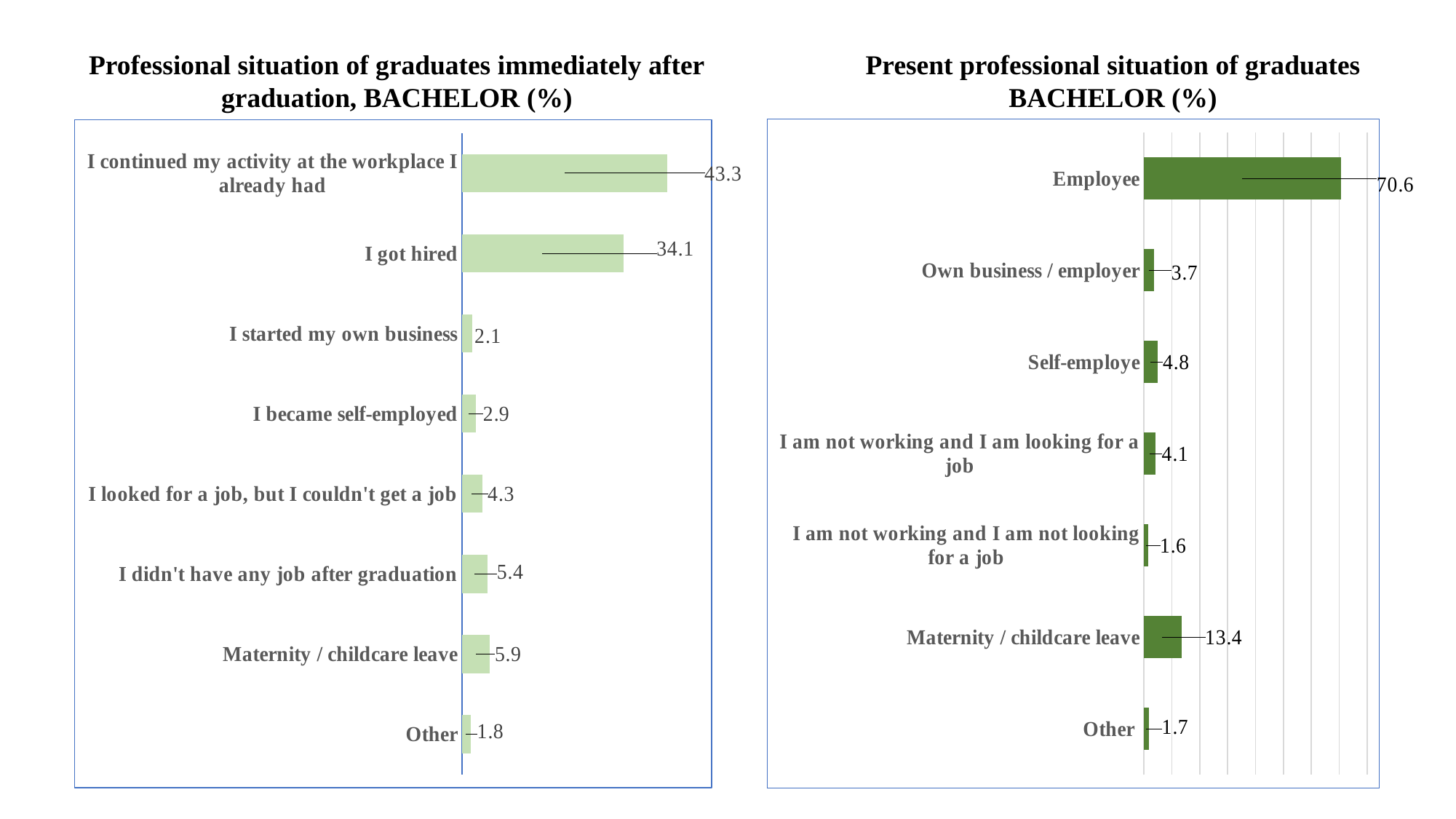
In the 'Professional situation of graduates immediately after graduation, BACHELOR (%)' chart, which is larger: 'Maternity / childcare leave' or 'I didn't have any job after graduation'? Maternity / childcare leave In the 'Professional situation of graduates immediately after graduation, BACHELOR (%)' chart, which category has the lowest value? Other In the 'Present professional situation of graduates BACHELOR (%)' chart, what is the difference between 'Self-employe' and 'Own business / employer'? 1.1 In the 'Professional situation of graduates immediately after graduation, BACHELOR (%)' chart, what is the value for 'I got hired'? 34.1 What type of chart is the 'Present professional situation of graduates BACHELOR (%)' chart? Bar chart In the 'Present professional situation of graduates BACHELOR (%)' chart, how many categories are shown? 7 In the 'Present professional situation of graduates BACHELOR (%)' chart, which category has the lowest value? I am not working and I am not looking for a job In the 'Present professional situation of graduates BACHELOR (%)' chart, what is the value for 'Employee'? 70.6 In the 'Present professional situation of graduates BACHELOR (%)' chart, what is the value for 'Maternity / childcare leave'? 13.4 In the 'Professional situation of graduates immediately after graduation, BACHELOR (%)' chart, which category has the highest value? I continued my activity at the workplace I already had In the 'Professional situation of graduates immediately after graduation, BACHELOR (%)' chart, how many categories are shown? 8 In the 'Professional situation of graduates immediately after graduation, BACHELOR (%)' chart, what is the difference between 'I continued my activity at the workplace I already had' and 'I got hired'? 9.2